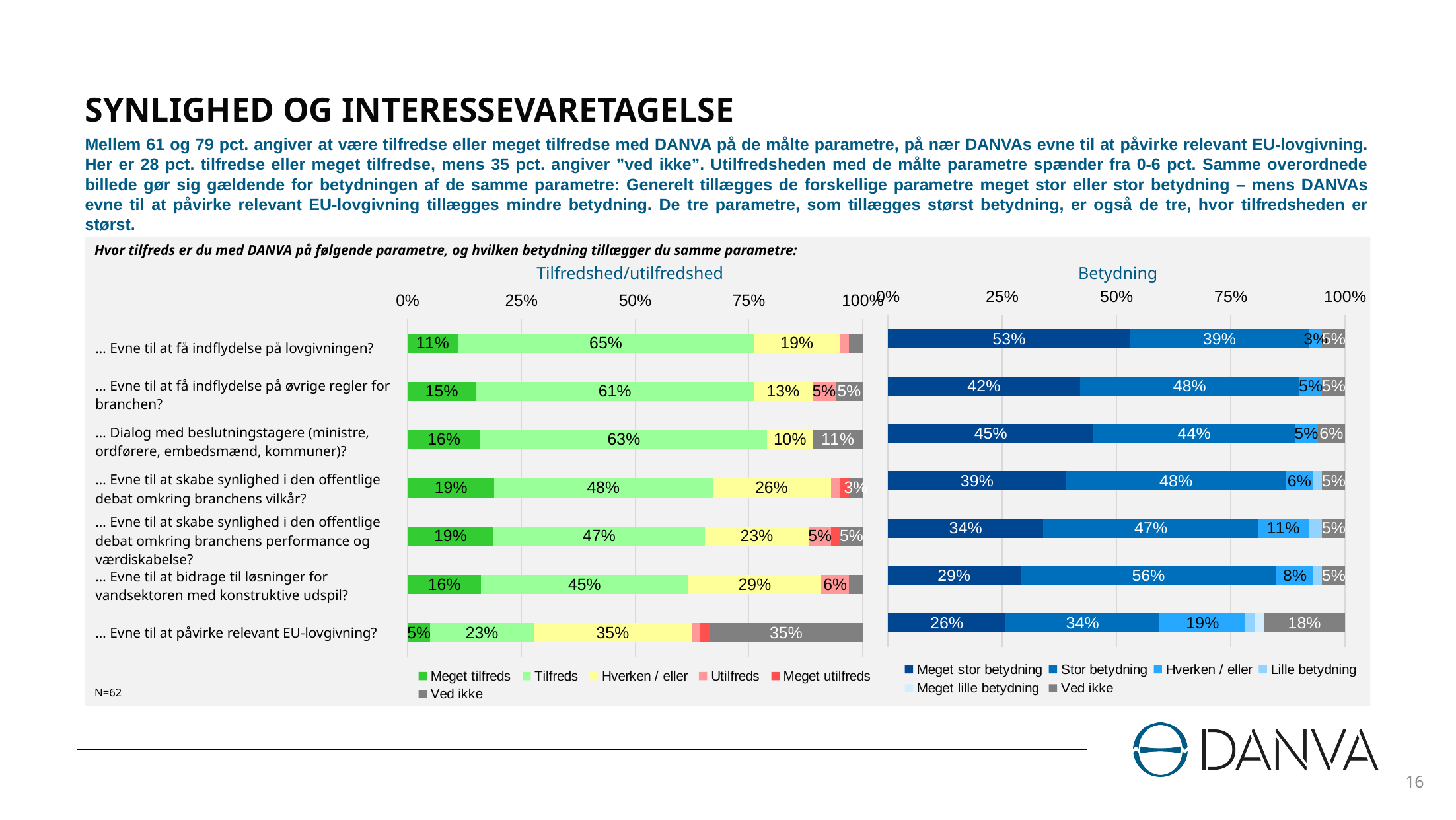
In the Tilfredshed/utilfredshed chart, which category has the lowest "Meget tilfreds" share? Evne til at påvirke relevant EU-lovgivning? In the Betydning chart, what is the difference between the "Stor betydning" shares for "Evne til at bidrage til løsninger for vandsektoren med konstruktive udspil?" and "Evne til at påvirke relevant EU-lovgivning?" 22% In the Betydning chart, what share answered "Meget stor betydning" for "Evne til at få indflydelse på lovgivningen?" 53% In the Betydning chart, what share answered "Hverken / eller" for "Evne til at skabe synlighed i den offentlige debat omkring branchens performance og værdiskabelse?" 11% What is the title of the left chart? Tilfredshed/utilfredshed In the Tilfredshed/utilfredshed chart, what share answered "Ved ikke" for "Evne til at påvirke relevant EU-lovgivning?" 35% What kind of chart is the Betydning chart? Stacked bar chart In the Tilfredshed/utilfredshed chart, what share answered "Tilfreds" for "Evne til at få indflydelse på lovgivningen?" 65% How many series does the legend of the Betydning chart list? 6 In the Tilfredshed/utilfredshed chart, which is larger: the "Hverken / eller" share for "Evne til at bidrage til løsninger for vandsektoren med konstruktive udspil?" or for "Dialog med beslutningstagere (ministre, ordførere, embedsmænd, kommuner)?" Evne til at bidrage til løsninger for vandsektoren med konstruktive udspil? In the Betydning chart, which category has the highest "Meget stor betydning" share? Evne til at få indflydelse på lovgivningen? How many categories are shown in the Tilfredshed/utilfredshed chart? 7